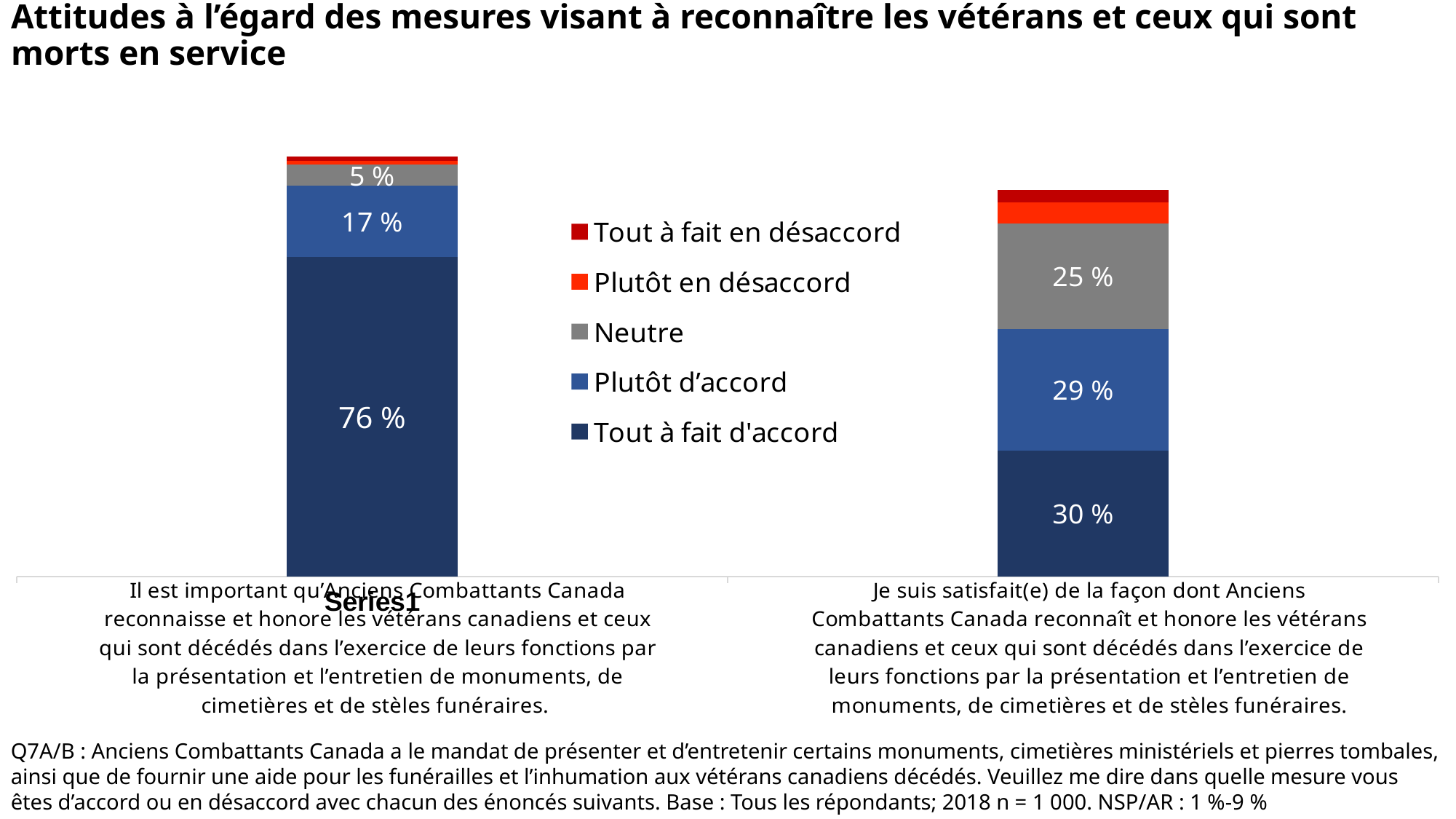
What percentage answered "Tout à fait d'accord" for the right bar ("Je suis satisfait(e) de la façon dont Anciens Combattants Canada...")? 30 % How many series does the legend list? 5 What is the "Neutre" value for the left bar ("Il est important qu'Anciens Combattants Canada...")? 5 % What is the "Plutôt d'accord" value for the right bar ("Je suis satisfait(e)...")? 29 % What is the "Neutre" value for the right bar ("Je suis satisfait(e)...")? 25 % How many stacked bars (statements) are shown in the chart? 2 What is the "Plutôt d'accord" value for the left bar ("Il est important qu'Anciens Combattants Canada...")? 17 % Which statement has the larger "Tout à fait d'accord" share: the left bar ("Il est important...") or the right bar ("Je suis satisfait(e)...")? The left bar ("Il est important...") What percentage of respondents answered "Tout à fait d'accord" for the left bar ("Il est important qu'Anciens Combattants Canada reconnaisse et honore...")? 76 % Which response category is the largest segment in the left bar ("Il est important...")? Tout à fait d'accord What kind of chart is shown on the slide? Stacked bar chart What is the difference in "Tout à fait d'accord" between the left bar (76 %) and the right bar (30 %)? 46 percentage points